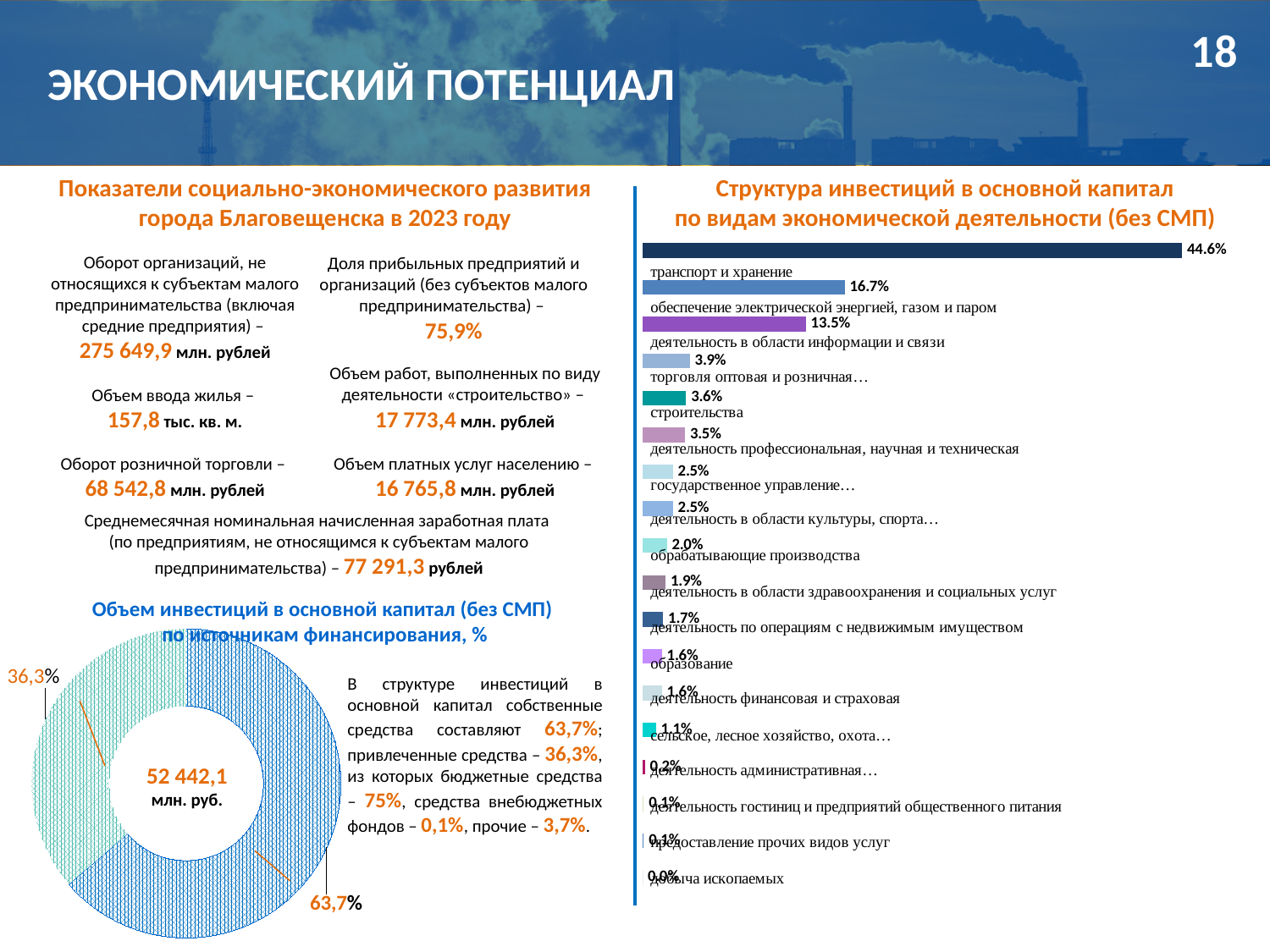
In the chart «Структура инвестиций в основной капитал по видам экономической деятельности (без СМП)», which category has the highest value? транспорт и хранение In the chart «Структура инвестиций в основной капитал по видам экономической деятельности (без СМП)», what is the difference between «транспорт и хранение» and «обеспечение электрической энергией, газом и паром»? 27.9% What value is printed in the centre of the donut chart «Объем инвестиций в основной капитал (без СМП) по источникам финансирования, %»? 52 442,1 млн. руб. How many categories are shown in the chart «Структура инвестиций в основной капитал по видам экономической деятельности (без СМП)»? 18 In the chart «Структура инвестиций в основной капитал по видам экономической деятельности (без СМП)», what is the value for «деятельность в области информации и связи»? 13.5% What kind of chart is the chart titled «Объем инвестиций в основной капитал (без СМП) по источникам финансирования, %»? donut chart What kind of chart is the chart titled «Структура инвестиций в основной капитал по видам экономической деятельности (без СМП)»? bar chart In the chart «Структура инвестиций в основной капитал по видам экономической деятельности (без СМП)», what is the value for «транспорт и хранение»? 44.6% In the donut chart «Объем инвестиций в основной капитал (без СМП) по источникам финансирования, %», what is the larger slice's share? 63,7% In the chart «Структура инвестиций в основной капитал по видам экономической деятельности (без СМП)», what is the value for «образование»? 1.6% In the chart «Структура инвестиций в основной капитал по видам экономической деятельности (без СМП)», which category has the lowest value? добыча ископаемых In the chart «Структура инвестиций в основной капитал по видам экономической деятельности (без СМП)», which is larger: «торговля оптовая и розничная…» or «обрабатывающие производства»? торговля оптовая и розничная…